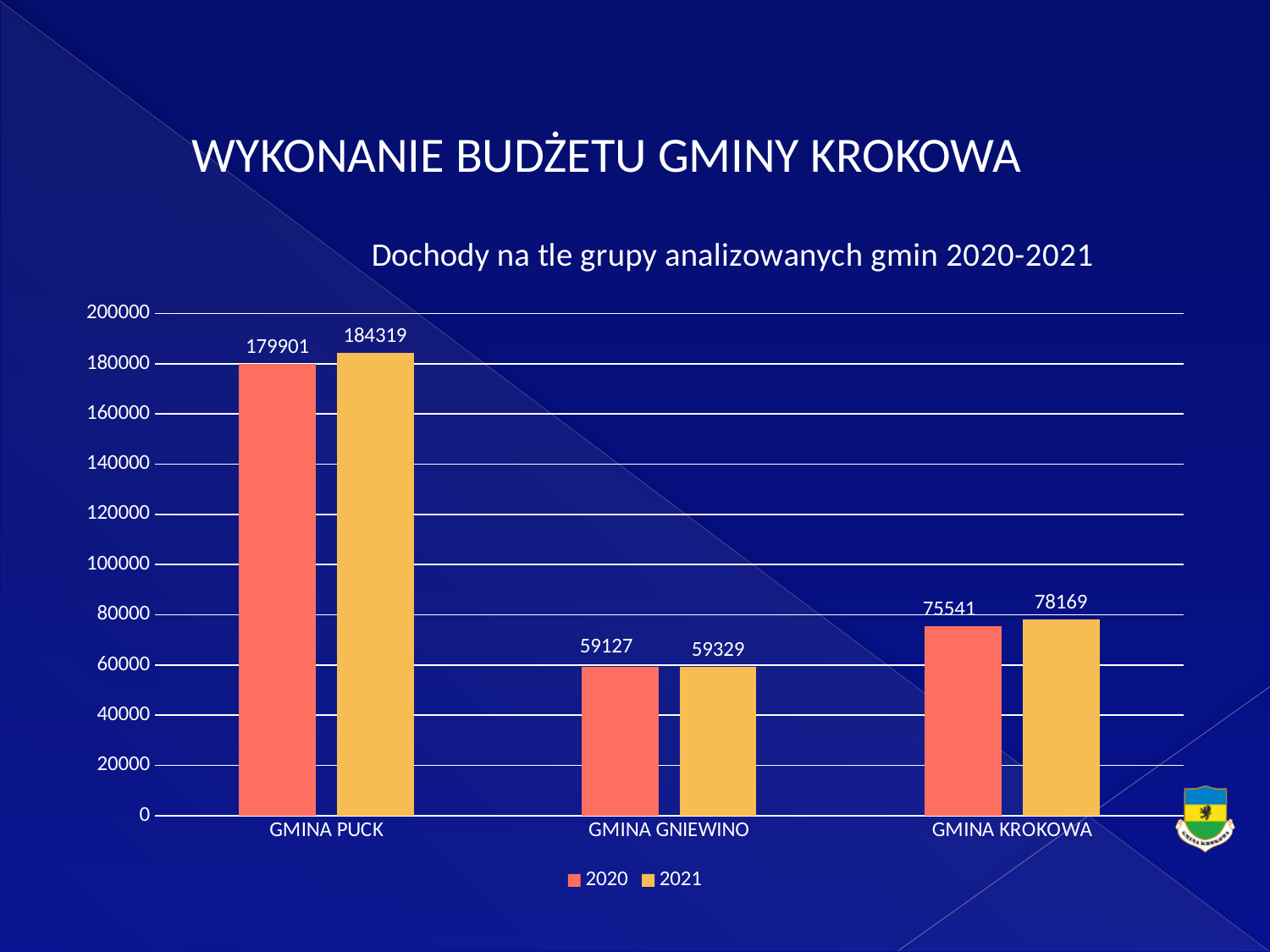
Is the 2020 value for GMINA KROKOWA greater or less than 80000? less What kind of chart is shown on the slide? bar chart How many categories are shown on the x axis? 3 What is the 2020 value for GMINA PUCK? 179901 What is the 2021 value for GMINA KROKOWA? 78169 What is the 2021 value for GMINA GNIEWINO? 59329 How many series does the legend list? 2 Which category has the highest 2021 value? GMINA PUCK Which is larger for GMINA KROKOWA, the 2020 value or the 2021 value? 2021 What is the difference between the 2021 and 2020 values for GMINA PUCK? 4418 Which category has the lowest 2020 value? GMINA GNIEWINO What is the difference between the 2021 and 2020 values for GMINA KROKOWA? 2628